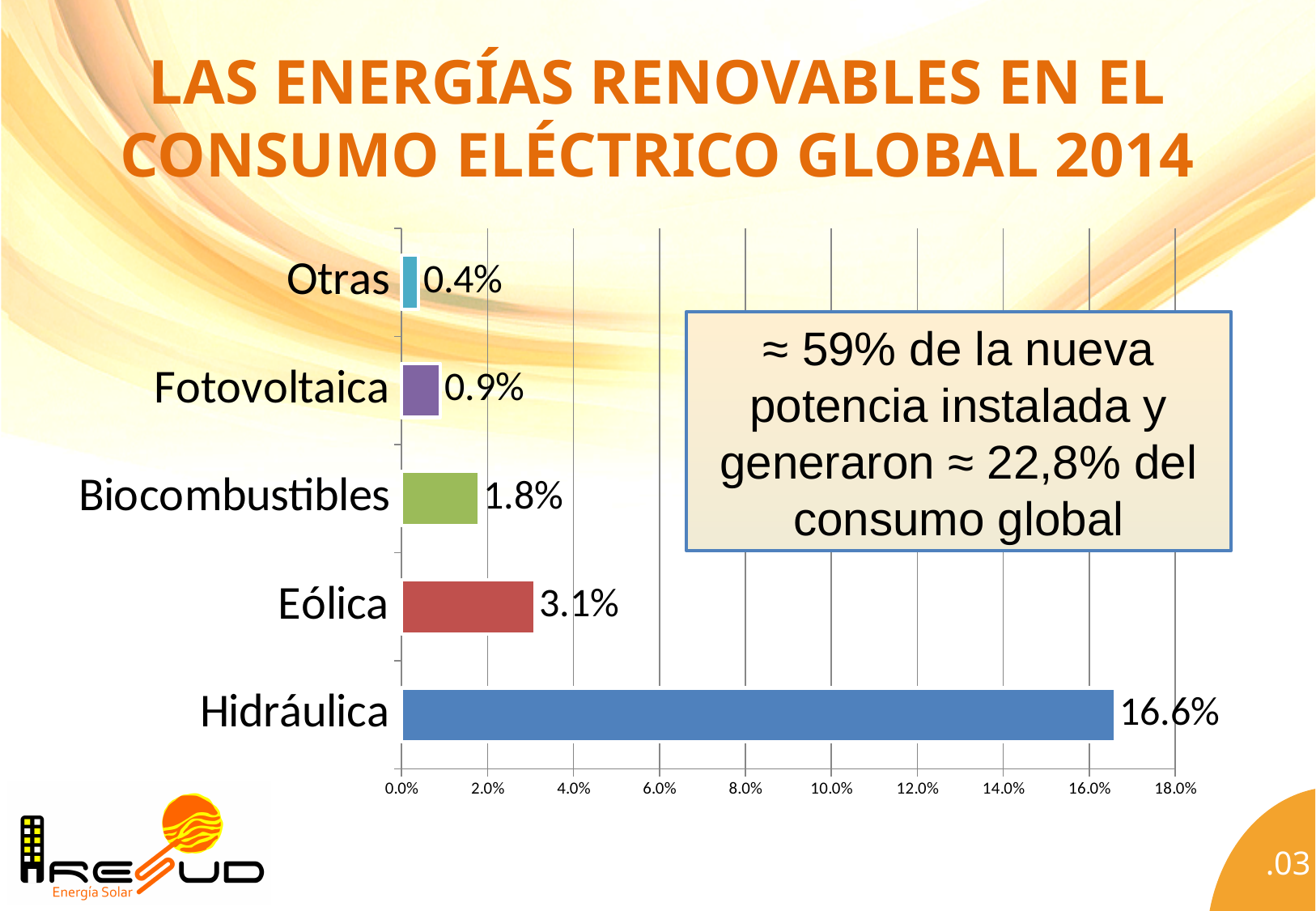
What is the value for Hidráulica? 16.6% Which is larger, the value for Biocombustibles or the value for Fotovoltaica? Biocombustibles Which category has the highest value? Hidráulica How many categories are shown in the chart? 5 What is the value for Biocombustibles? 1.8% What is the value for Fotovoltaica? 0.9% What is the difference between the values for Hidráulica and Eólica? 13.5% What is the value for Eólica? 3.1% What is the highest tick label shown on the x axis? 18.0% What kind of chart is shown on the slide? bar chart What is the value for Otras? 0.4% Which category has the lowest value? Otras